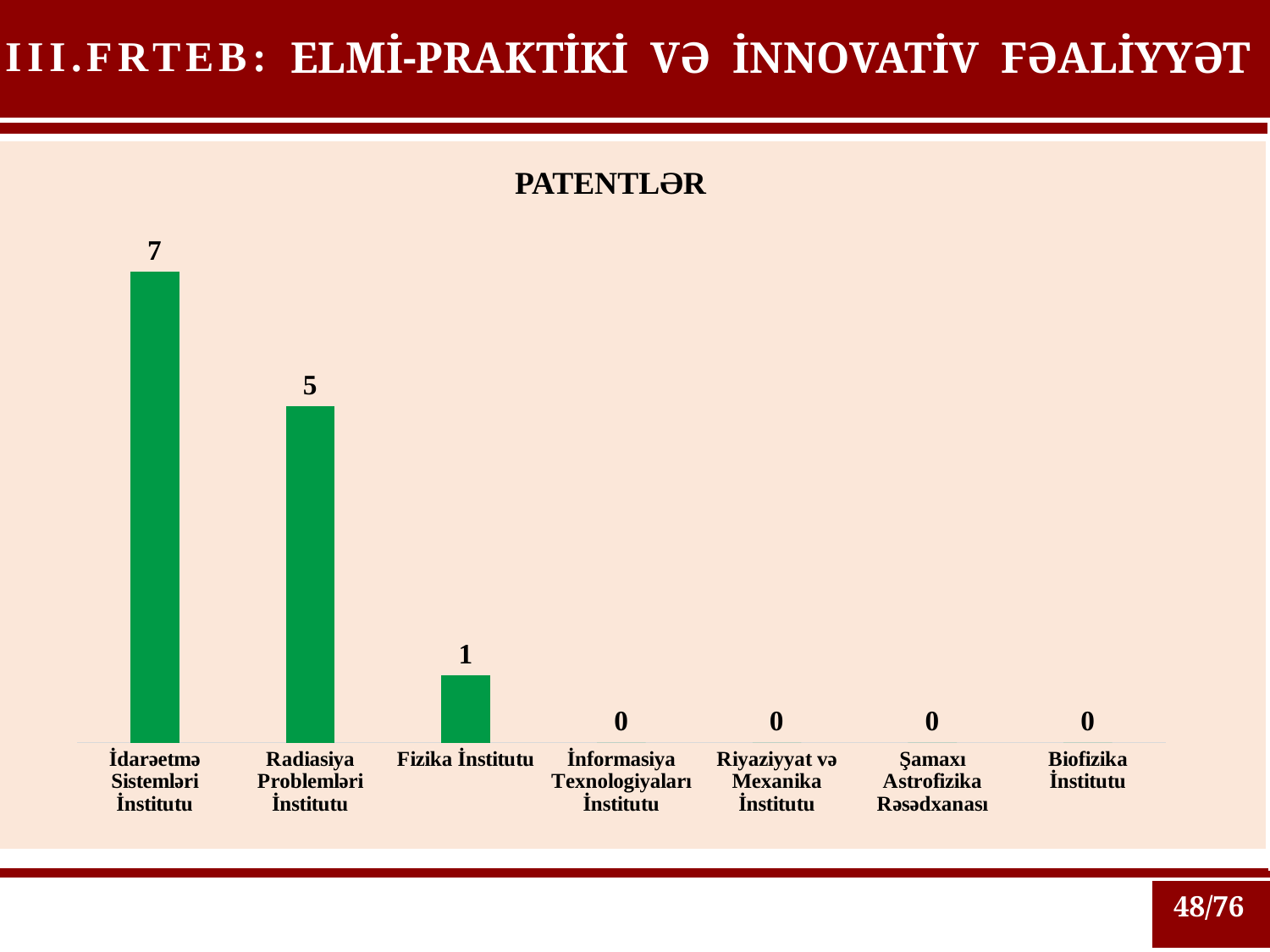
How many categories have a value of 0? 4 How many categories are shown on the x axis? 7 What is the value for Radiasiya Problemləri İnstitutu? 5 What kind of chart is shown? bar chart What is the value for İdarəetmə Sistemləri İnstitutu? 7 Which is larger, the value for Radiasiya Problemləri İnstitutu or the value for Fizika İnstitutu? Radiasiya Problemləri İnstitutu What is the value for Biofizika İnstitutu? 0 Which category has the highest value? İdarəetmə Sistemləri İnstitutu What is the difference between the values for İdarəetmə Sistemləri İnstitutu and Radiasiya Problemləri İnstitutu? 2 What is the difference between the values for Radiasiya Problemləri İnstitutu and Fizika İnstitutu? 4 What is the title of the chart? PATENTLƏR What is the value for Fizika İnstitutu? 1